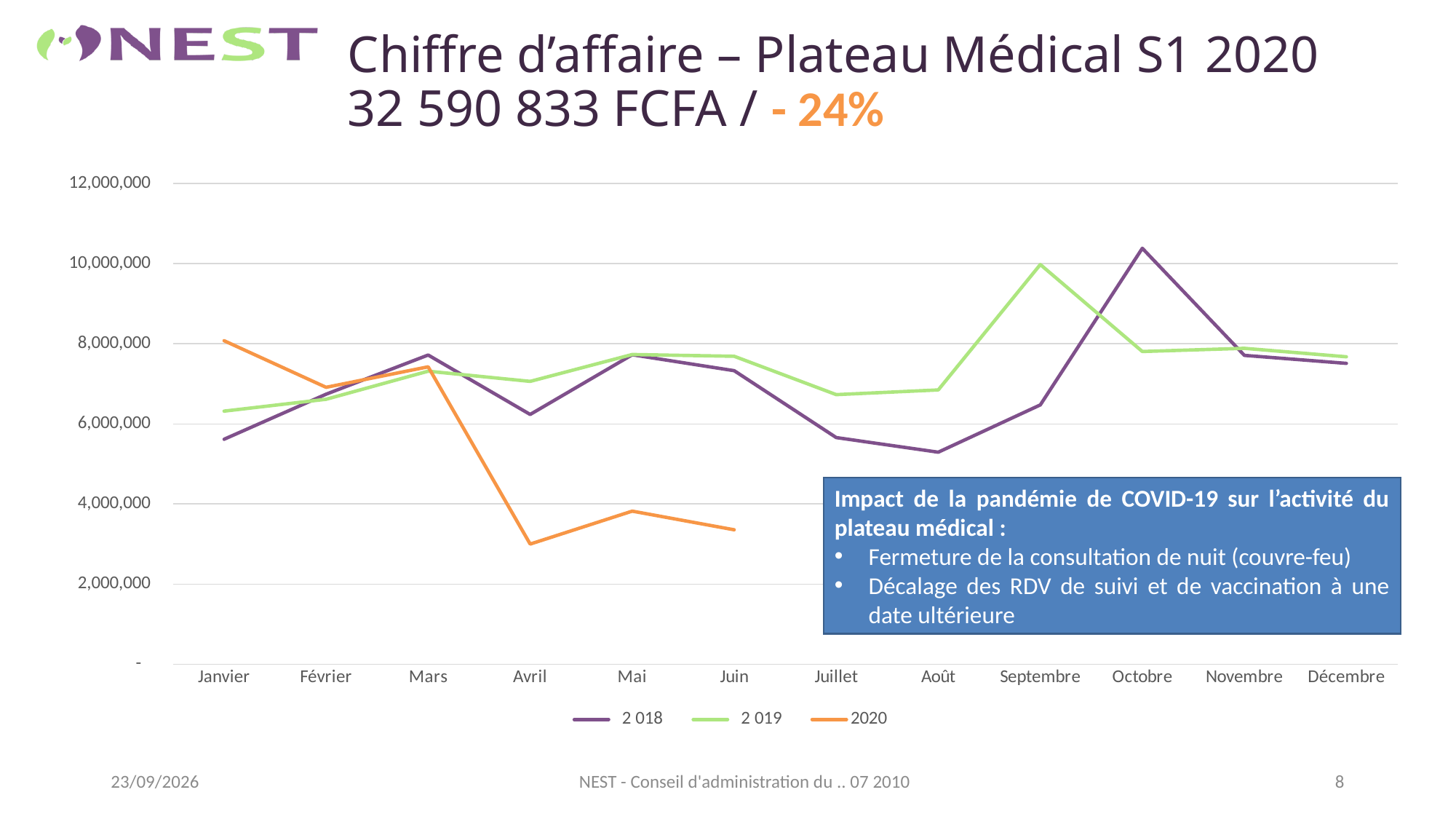
Which series are listed in the legend? 2 018, 2 019, 2020 In which month does the 2 019 series reach its highest value? Septembre How many months are shown on the x axis? 12 Is the value for 2020 in Avril greater or less than 4,000,000? less How many series does the legend list? 3 Is the value for 2 018 in Août greater or less than 6,000,000? less In Avril, which series has the higher value, 2 018 or 2 019? 2 019 Is the value for 2 018 in Octobre greater or less than 10,000,000? greater In which month does the 2 018 series reach its highest value? Octobre What kind of chart is shown on the slide? line chart In which month does the 2020 series reach its lowest value? Avril Does the 2020 series rise or fall from Mars to Avril? fall